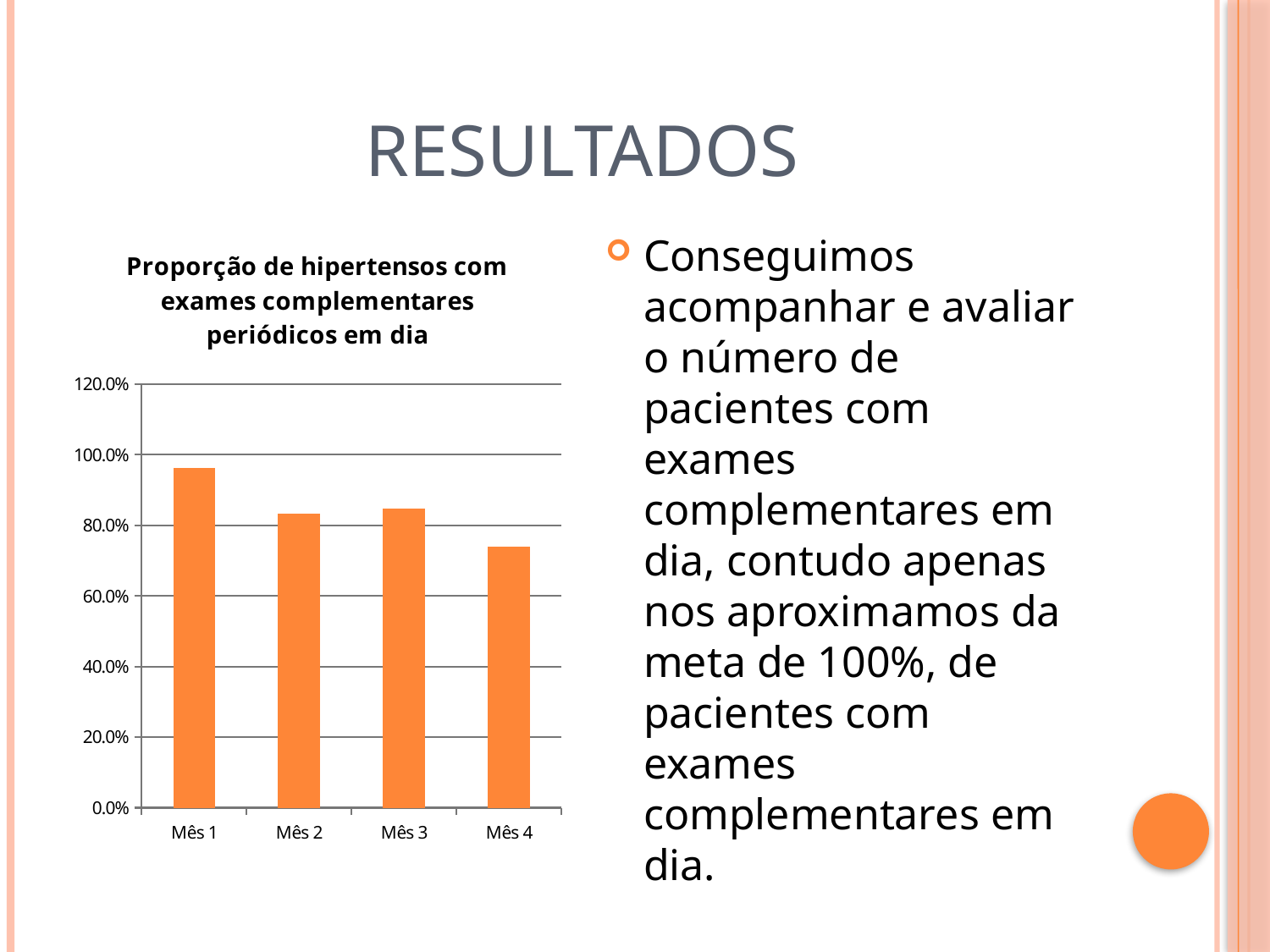
Which month has the lowest value? Mês 4 Which is larger, the value for Mês 1 or the value for Mês 4? Mês 1 Which month has the highest value? Mês 1 What is the title of the chart? Proporção de hipertensos com exames complementares periódicos em dia How many categories (months) are plotted on the x axis? 4 Is the value for Mês 4 greater or less than 60.0%? greater Is the value for Mês 4 greater or less than 80.0%? less Is the value for Mês 3 greater or less than 80.0%? greater What kind of chart is shown on the slide? bar chart What colour are the bars in the chart? orange